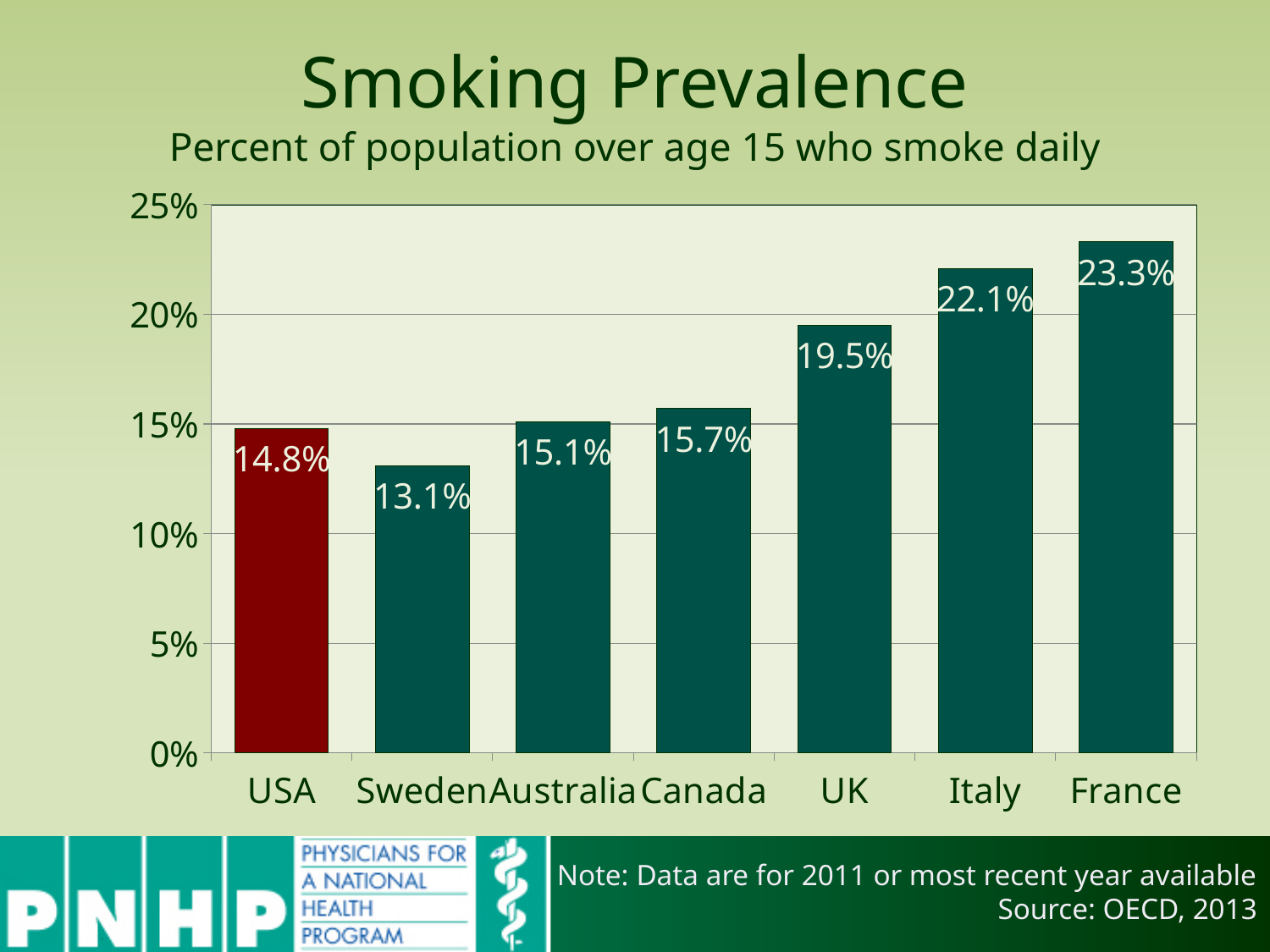
What is the smoking prevalence value shown for Italy? 22.1% Is the value for Italy greater or less than 20%? greater Which country has the lowest smoking prevalence on the chart? Sweden How many countries are shown on the chart? 7 Which country has the highest smoking prevalence on the chart? France What is the smoking prevalence value shown for Canada? 15.7% What is the smoking prevalence value shown for the USA? 14.8% What is the difference in smoking prevalence between France and the USA? 8.5% Which country's bar is coloured differently (red) from the others? USA What is the difference in smoking prevalence between the UK and Sweden? 6.4% Which has a higher smoking prevalence, Australia or the UK? UK What kind of chart is shown on the slide? Bar chart